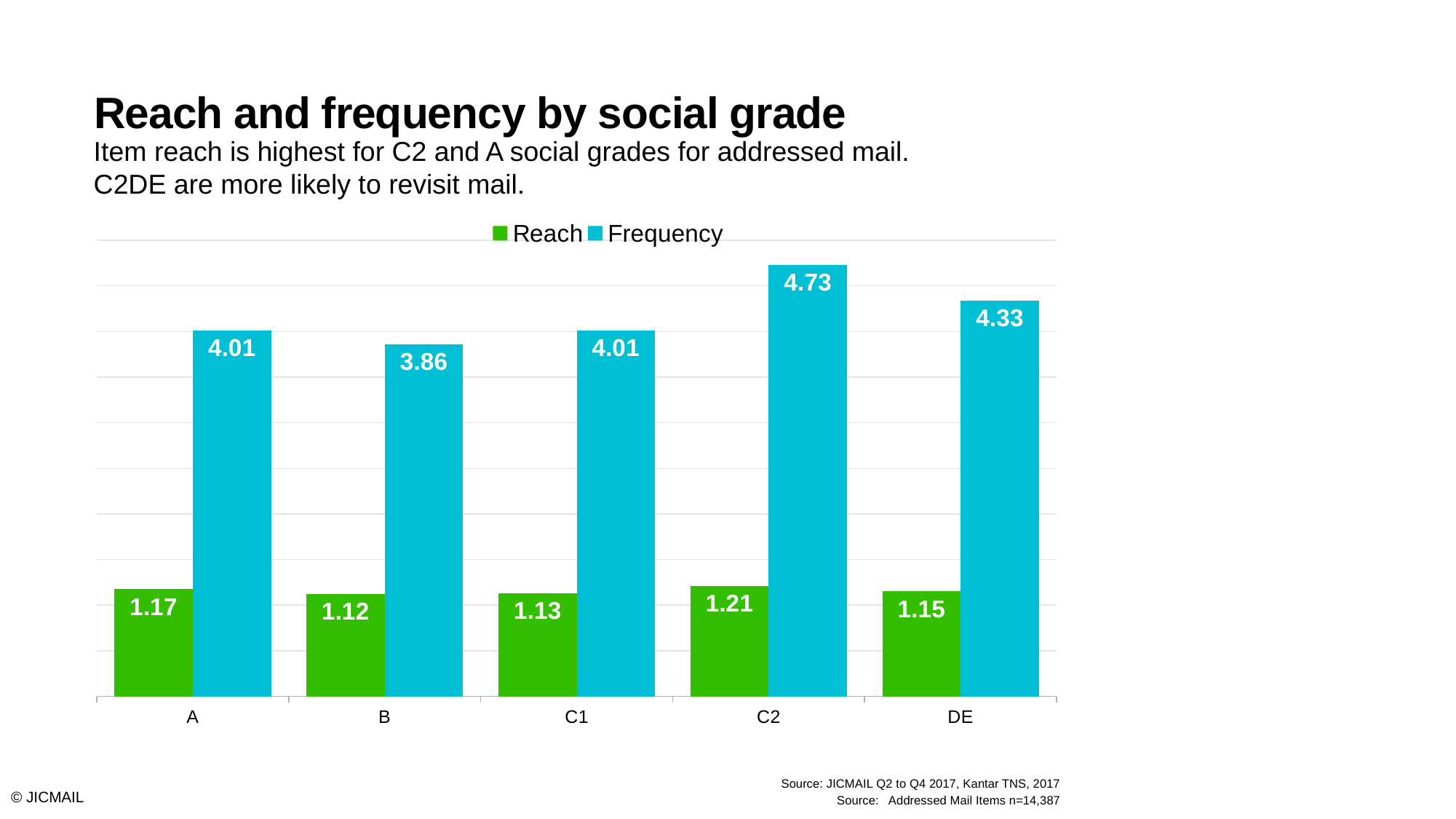
What is the Frequency value for social grade B? 3.86 Which colour represents the Frequency series in the chart? Blue What is the difference between the Reach values for C2 and DE? 0.06 Which social grade has the lowest Reach value? B Which social grade has the highest Frequency value? C2 What is the Reach value for social grade C2? 1.21 How many series does the legend list? 2 What is the Frequency value for social grade DE? 4.33 What kind of chart is shown on the slide? Bar chart What is the difference between the Frequency values for C2 and B? 0.87 Which is larger, the Frequency value for DE or the Frequency value for C1? DE How many social grade categories are shown on the x axis? 5